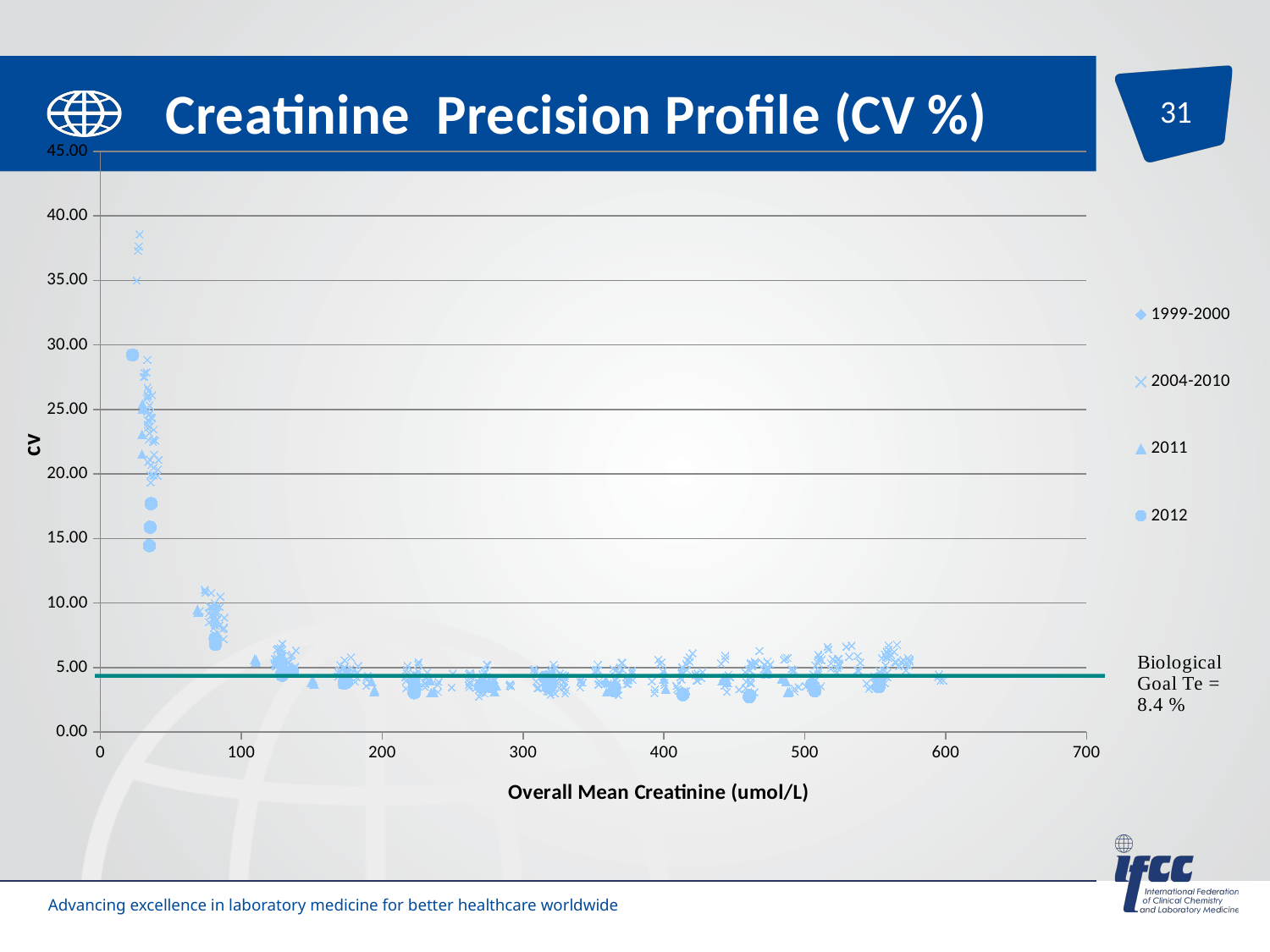
Is the highest plotted CV value greater or less than 35.00? greater Are the CV values for points with Overall Mean Creatinine above 200 umol/L greater or less than 10.00? less What kind of chart is shown on the slide? Scatter chart What is the maximum value shown on the x axis? 700 How many series does the legend list? 4 What Biological Goal Te value is stated next to the chart? 8.4 % What is the label of the x axis? Overall Mean Creatinine (umol/L) Is the CV value of the highest 2012 point (near 25 umol/L) greater or less than 25.00? greater What is the title of the chart? Creatinine Precision Profile (CV %) Which series in the legend covers the years 2004 to 2010? 2004-2010 As Overall Mean Creatinine increases along the x axis, does the CV generally rise or fall? Fall What is the maximum value shown on the CV axis? 45.00